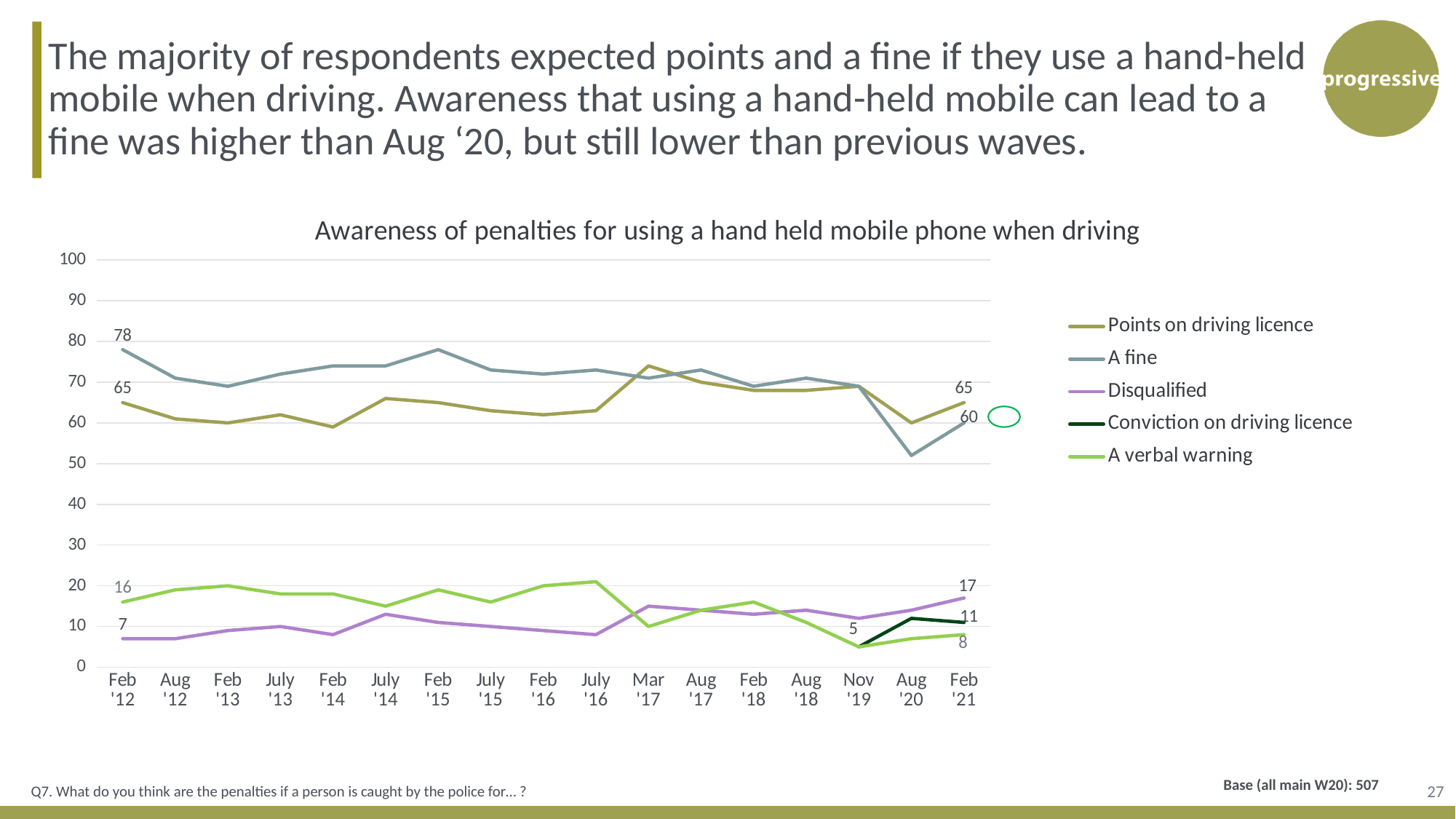
What is the value for 'Points on driving licence' at Feb '21? 65 By how much did the value for 'Disqualified' rise from Feb '12 to Feb '21? 10 By how much did the value for 'A fine' fall from Feb '12 to Feb '21? 18 What is the value for 'A fine' at Feb '12? 78 Which series has the highest value at Feb '12? A fine How many series does the legend list? 5 What is the value for 'A verbal warning' at Feb '12? 16 What is the value for 'Conviction on driving licence' at Feb '21? 11 At Feb '21, which is higher: 'Points on driving licence' or 'A fine'? Points on driving licence Is the value for 'A fine' at Aug '20 greater or less than 60? less What kind of chart is shown on the slide? line chart What is the value for 'Disqualified' at Feb '21? 17